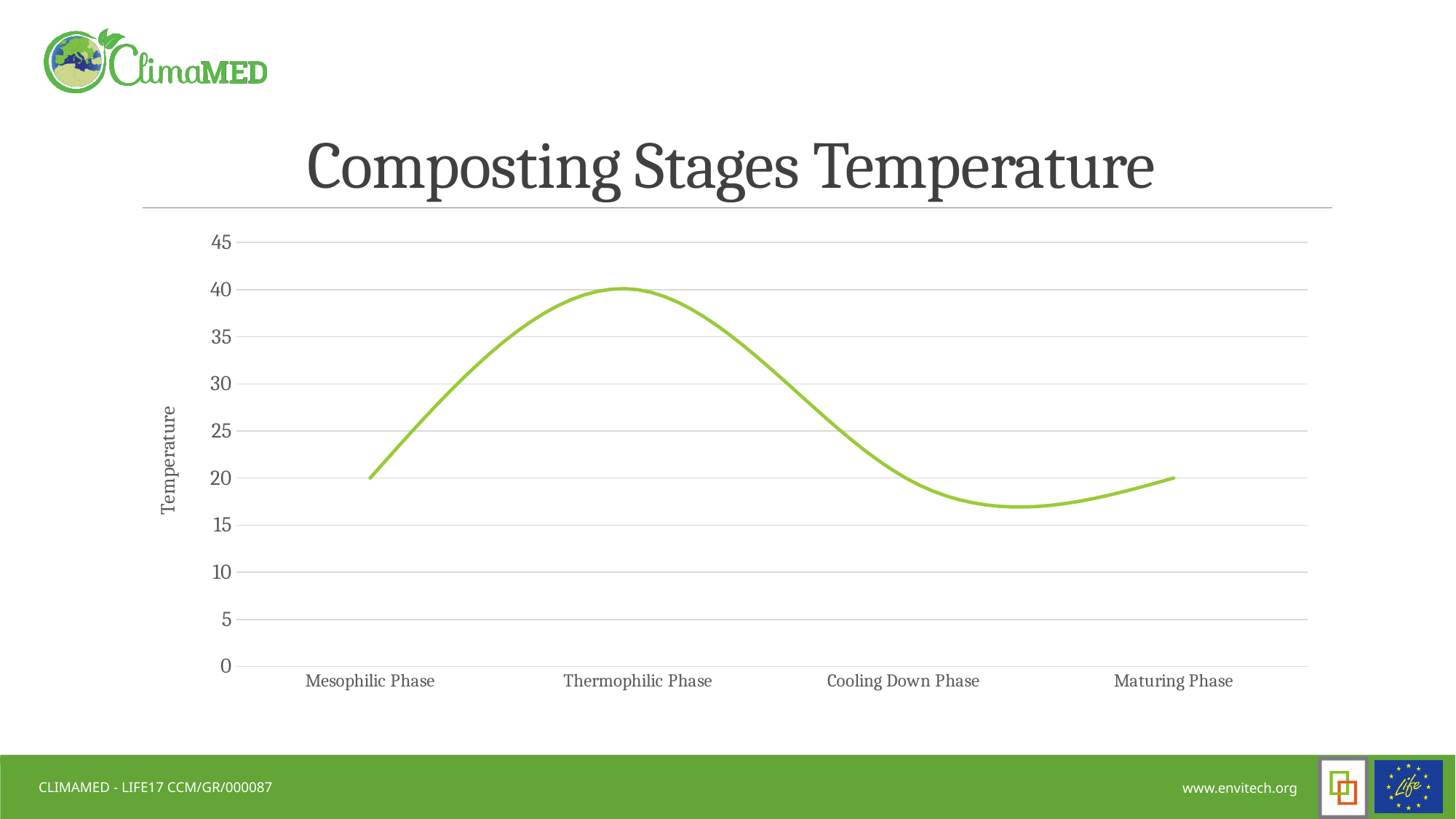
What is the title of the chart? Composting Stages Temperature Which is larger, the temperature for the Thermophilic Phase or the Mesophilic Phase? Thermophilic Phase Which phase has the highest temperature? Thermophilic Phase Is the value for the Thermophilic Phase greater or less than 35? greater What is the temperature value for the Mesophilic Phase? 20 What is the temperature value for the Maturing Phase? 20 What is the label on the vertical axis? Temperature Is the value for the Mesophilic Phase greater or less than 25? less What kind of chart is shown on the slide? line chart What is the temperature value for the Thermophilic Phase? 40 How many composting phases are plotted along the x axis? 4 What is the difference between the Thermophilic Phase and Mesophilic Phase temperatures? 20